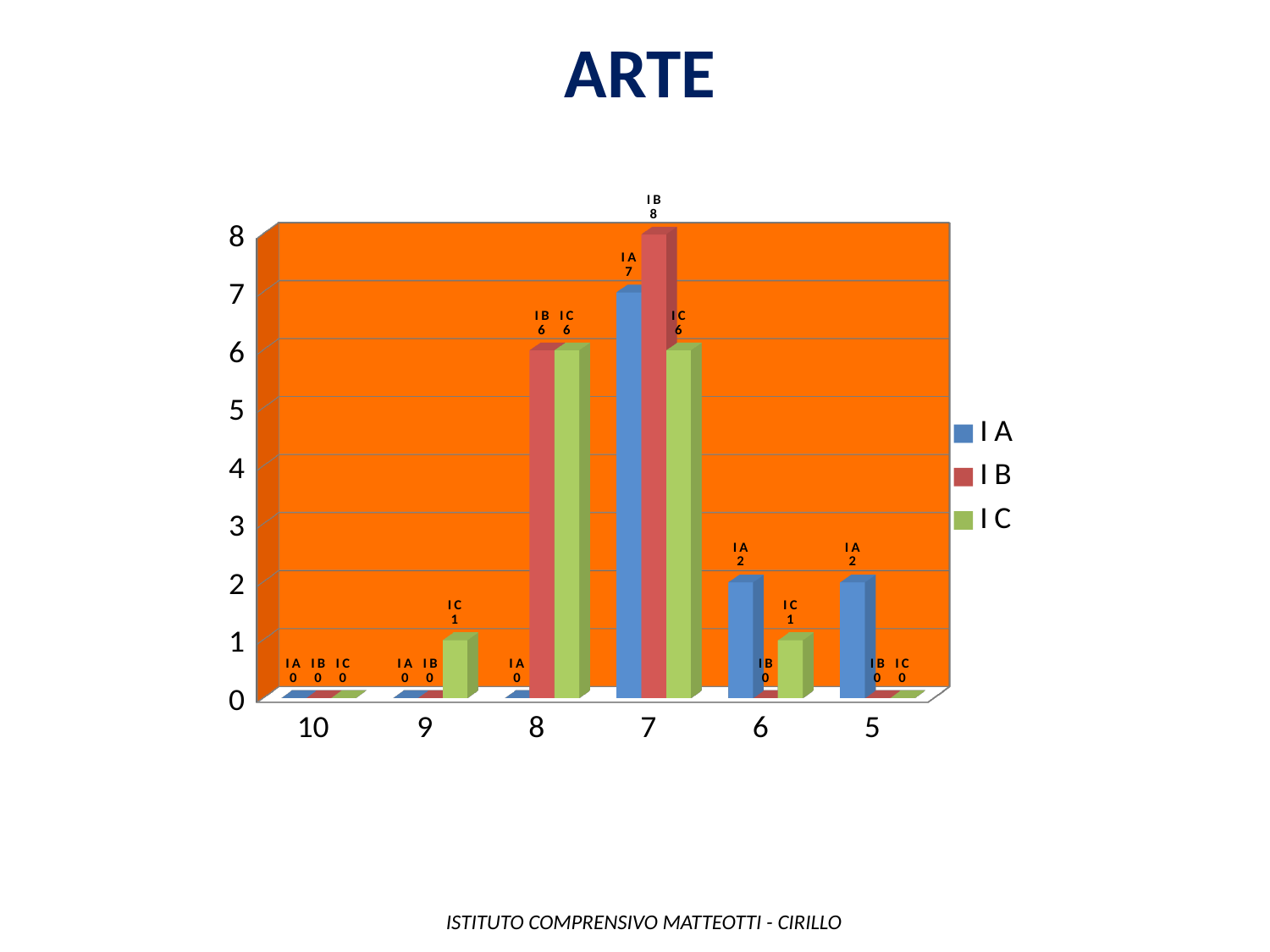
What is the value for I B at category 7? 8 What is the value for I C at category 9? 1 What kind of chart is shown? bar chart What is the title of the chart? ARTE What is the difference between I C at category 8 and I C at category 9? 5 Which is larger at category 7: I B or I C? I B What is the value for I A at category 6? 2 Which category has the highest value for I A? 7 How many series does the legend list? 3 What is the value for I B at category 8? 6 What is the difference between I B and I A at category 7? 1 How many categories are shown on the x axis? 6